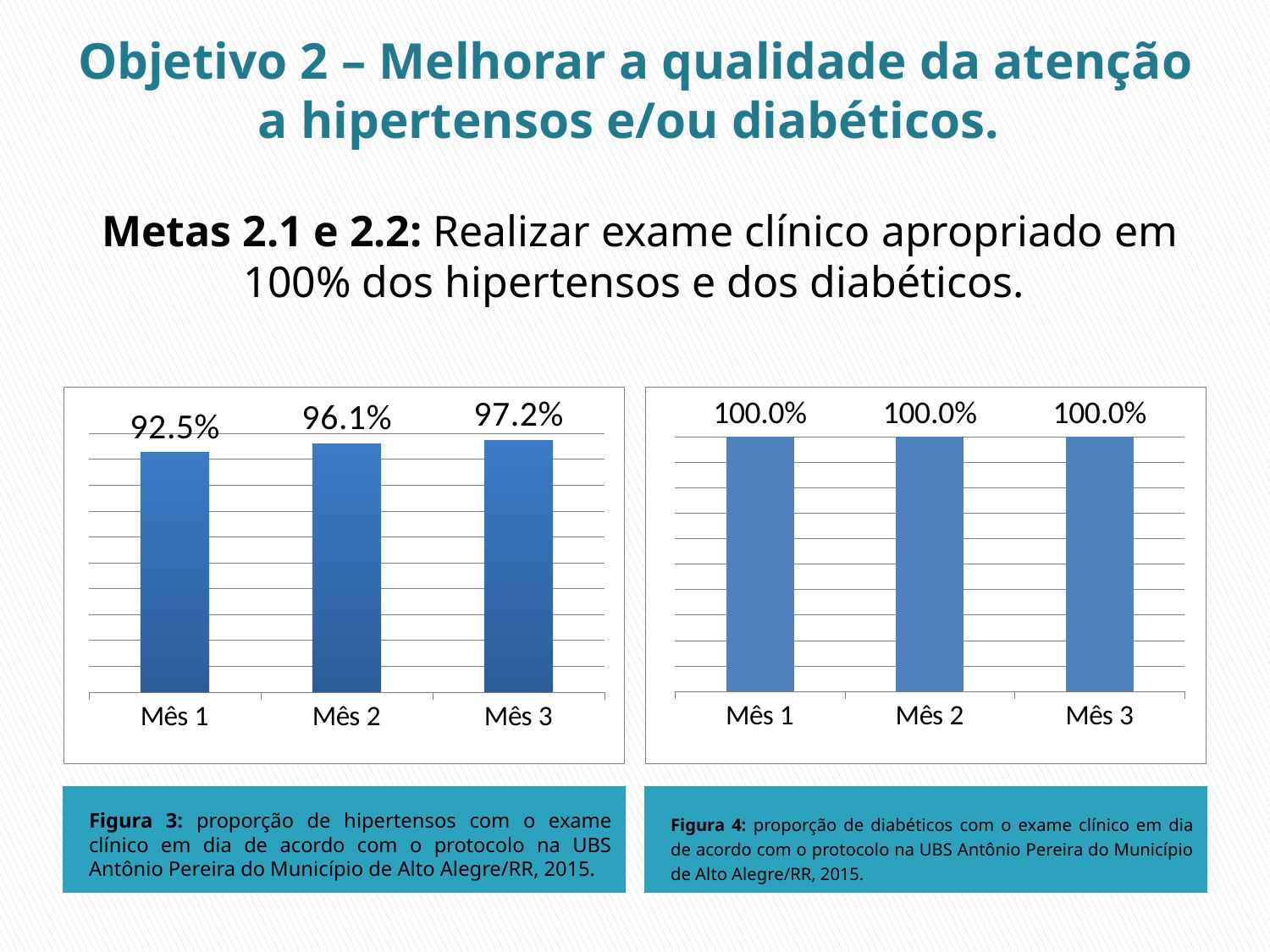
In the left chart (Figura 3), what is the value for Mês 3? 97.2% In the left chart (Figura 3), what is the difference between the values for Mês 2 and Mês 1? 3.6% In the left chart (Figura 3), what is the difference between the values for Mês 3 and Mês 1? 4.7% How many months are shown on the x axis of the right chart (Figura 4)? 3 In the left chart (Figura 3), which month has the highest value? Mês 3 In the left chart (Figura 3), do the values rise or fall from Mês 1 to Mês 3? Rise In the right chart (Figura 4), what is the value for Mês 2? 100.0% In the left chart (Figura 3), what is the value for Mês 1? 92.5% In the left chart (Figura 3), which month has the lowest value? Mês 1 In the right chart (Figura 4), do the values change from Mês 1 to Mês 3? No, they stay at 100.0% In the left chart (Figura 3), which is larger, the value for Mês 2 or Mês 3? Mês 3 What kind of chart is the left chart (Figura 3)? Bar chart